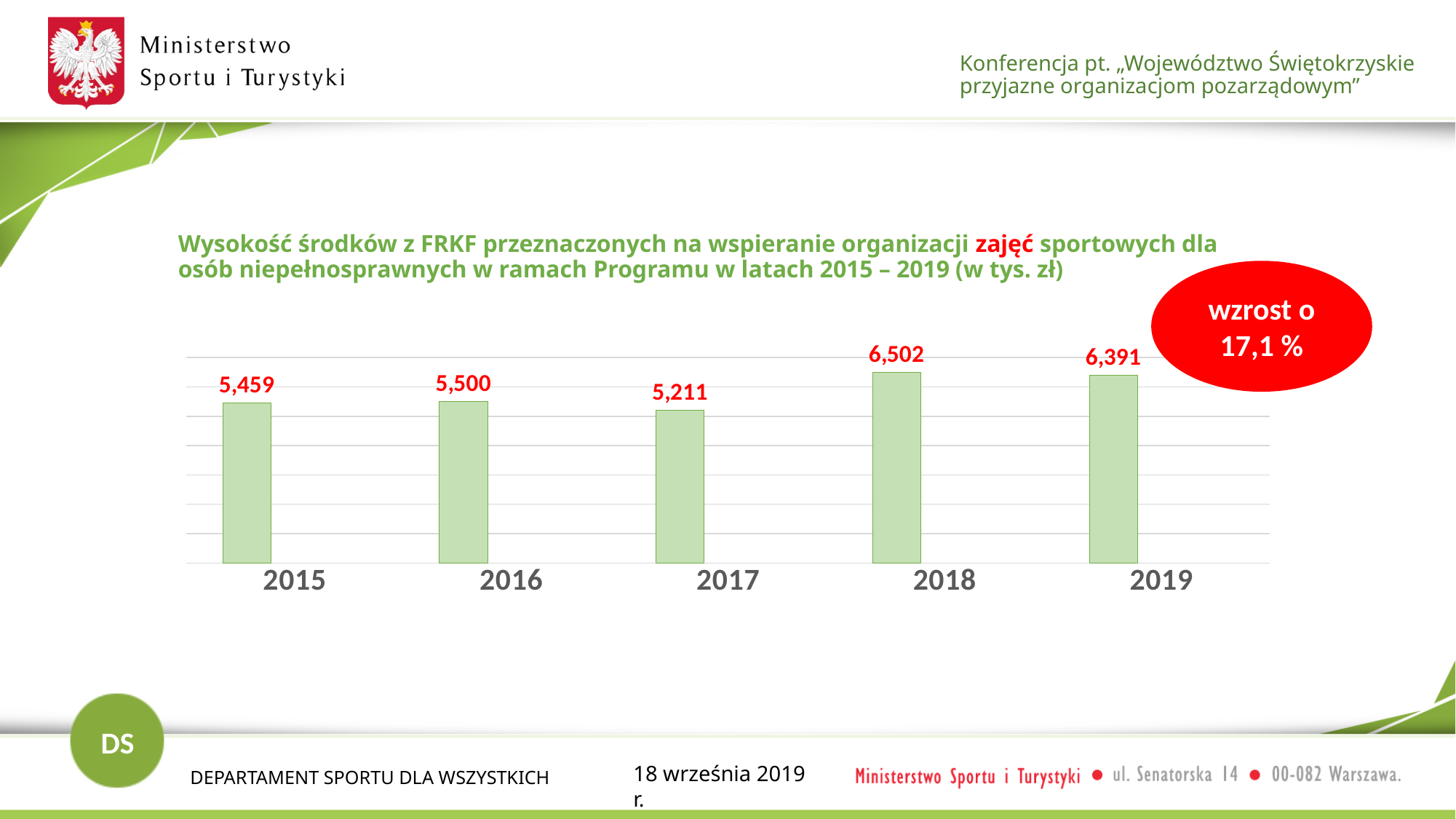
Which is larger, the value for 2018 or the value for 2019? 2018 Does the value rise or fall from 2016 to 2017? fall What is the difference between the values for 2016 and 2015? 41 What is the value for 2017? 5,211 Which year has the lowest value? 2017 What is the difference between the values for 2018 and 2017? 1,291 Which year has the highest value? 2018 How many years are shown on the x axis? 5 What is the value for 2019? 6,391 What kind of chart is shown on the slide? bar chart What percentage increase is stated in the red oval on the slide? 17,1 % What is the value for 2015? 5,459